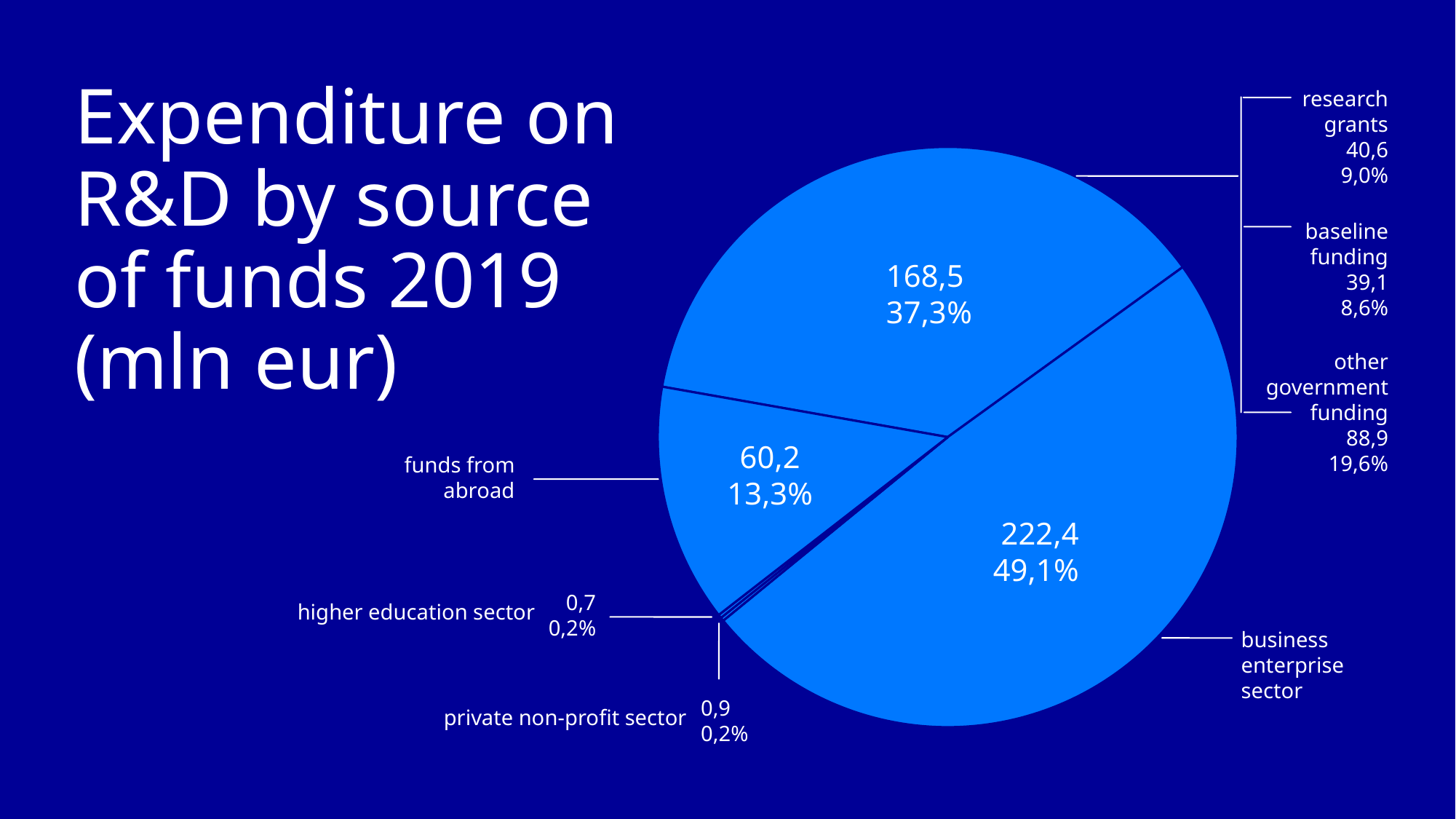
What is the value for the business enterprise sector? 222,4 What share of the pie does the business enterprise sector account for? 49,1% What is the title of the chart? Expenditure on R&D by source of funds 2019 (mln eur) What is the difference between the value for the business enterprise sector and the value for funds from abroad? 162,2 Which source of funds has the largest slice of the pie? business enterprise sector What share of the pie do funds from abroad account for? 13,3% What share of the pie does baseline funding account for? 8,6% What is the value for funds from abroad? 60,2 Which is larger, the value for the higher education sector or the private non-profit sector? private non-profit sector What kind of chart is shown on the slide? pie chart What is the value for research grants? 40,6 What is the value for other government funding? 88,9